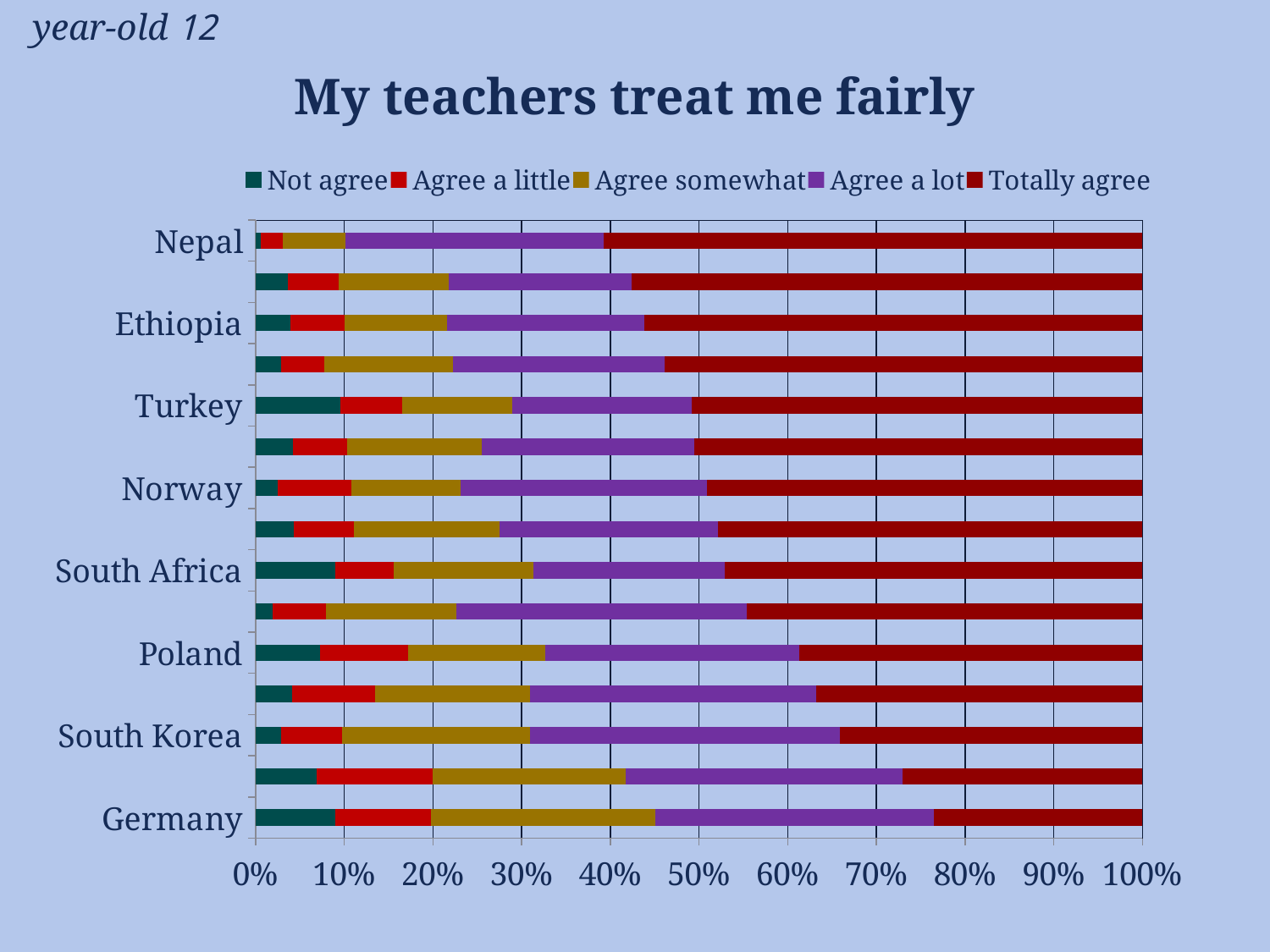
Is the Totally agree share for Germany greater or less than 30%? less Which has a larger Totally agree share, Nepal or Germany? Nepal Does the Totally agree share rise or fall going from Nepal at the top to Germany at the bottom? fall Which labelled country has the largest Totally agree share? Nepal How many series does the legend list? 5 Which labelled country has the smallest Totally agree share? Germany What is the title of the chart? My teachers treat me fairly How many country labels are shown on the vertical axis? 8 Is the Totally agree share for Nepal greater or less than 50%? greater What kind of chart is shown on the slide? Stacked bar chart Is the Not agree share for Poland greater or less than 10%? less Which series is shown in dark red in the legend? Totally agree